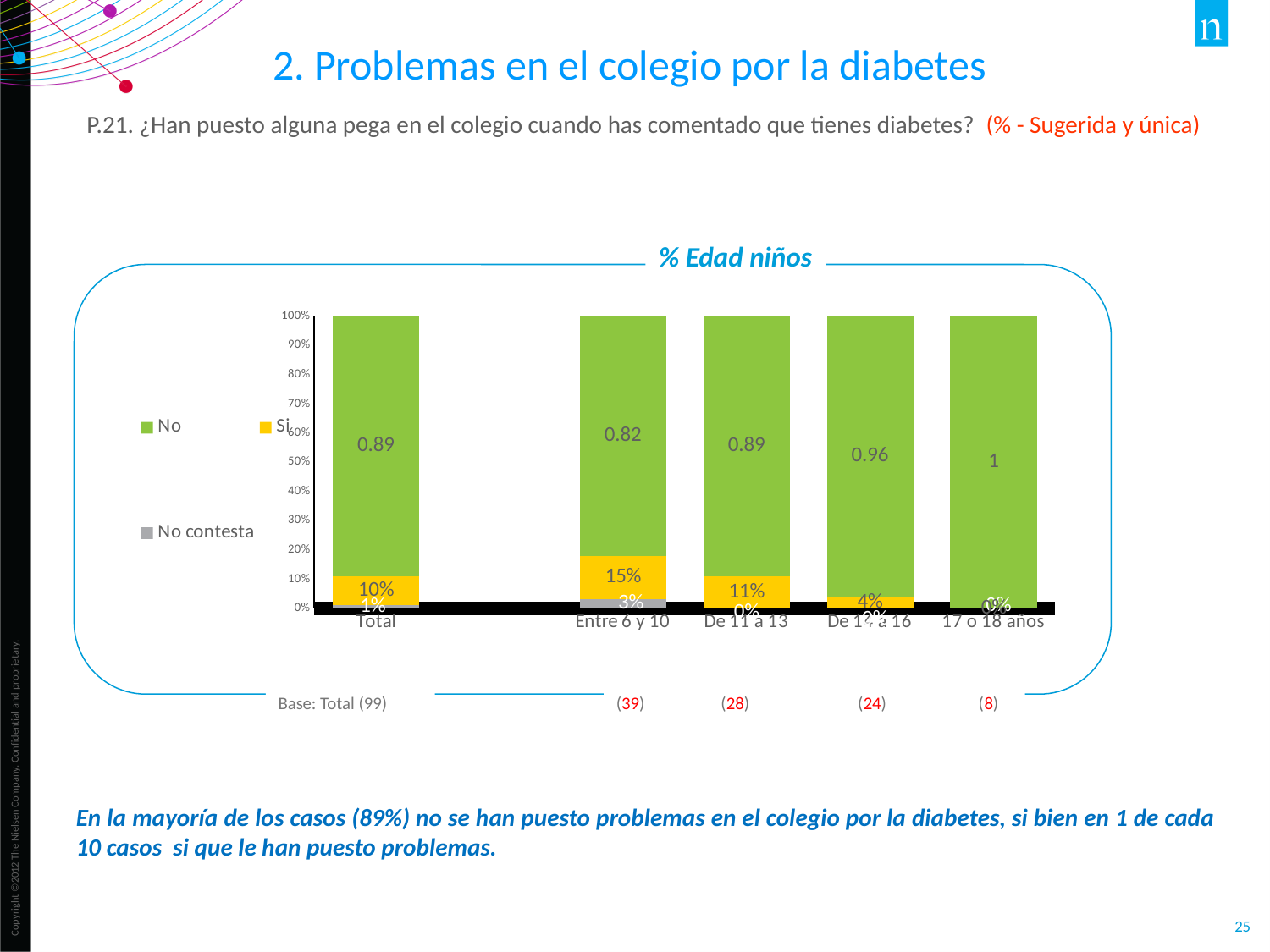
How many categories are plotted along the x axis of the chart? 5 What is the value of the 'Si' series for the 'De 14 a 16' category? 4% What is the value of the 'Si' series for the 'Entre 6 y 10' category? 15% What is the value of the 'No' series for the Total category? 0.89 How many series does the chart legend list? 3 What is the title shown above the chart? % Edad niños What kind of chart is shown on the slide? Stacked bar chart Which category has the highest value for the 'Si' series? Entre 6 y 10 Which is larger: the 'Si' value for 'De 11 a 13' or for 'De 14 a 16'? De 11 a 13 What is the value of the 'No contesta' series for the 'Entre 6 y 10' category? 3% Which category has the lowest value for the 'No' series? Entre 6 y 10 What is the value of the 'No' series for the '17 o 18 años' category? 1